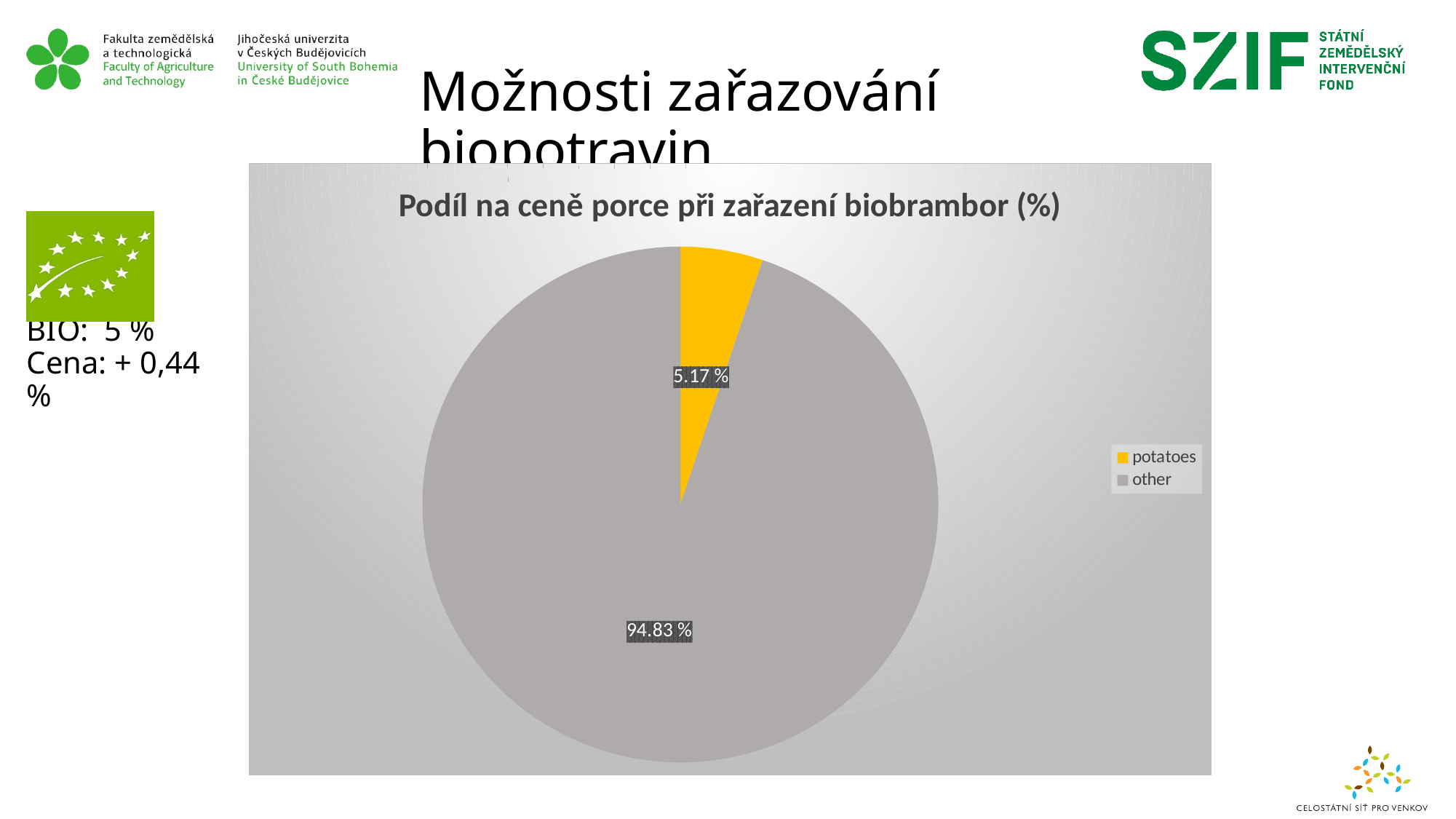
How many entries does the legend list? 2 What colour is the potatoes slice? yellow What kind of chart is shown on the slide? pie chart What is the difference between the other slice and the potatoes slice? 89.66 % What is the value shown for the other slice? 94.83 % What is the value shown for the potatoes slice? 5.17 % Which category has the largest share of the pie? other Which is larger, the potatoes slice or the other slice? other What is the title of the chart? Podíl na ceně porce při zařazení biobrambor (%) Which category has the smallest share of the pie? potatoes How many slices does the pie chart have? 2